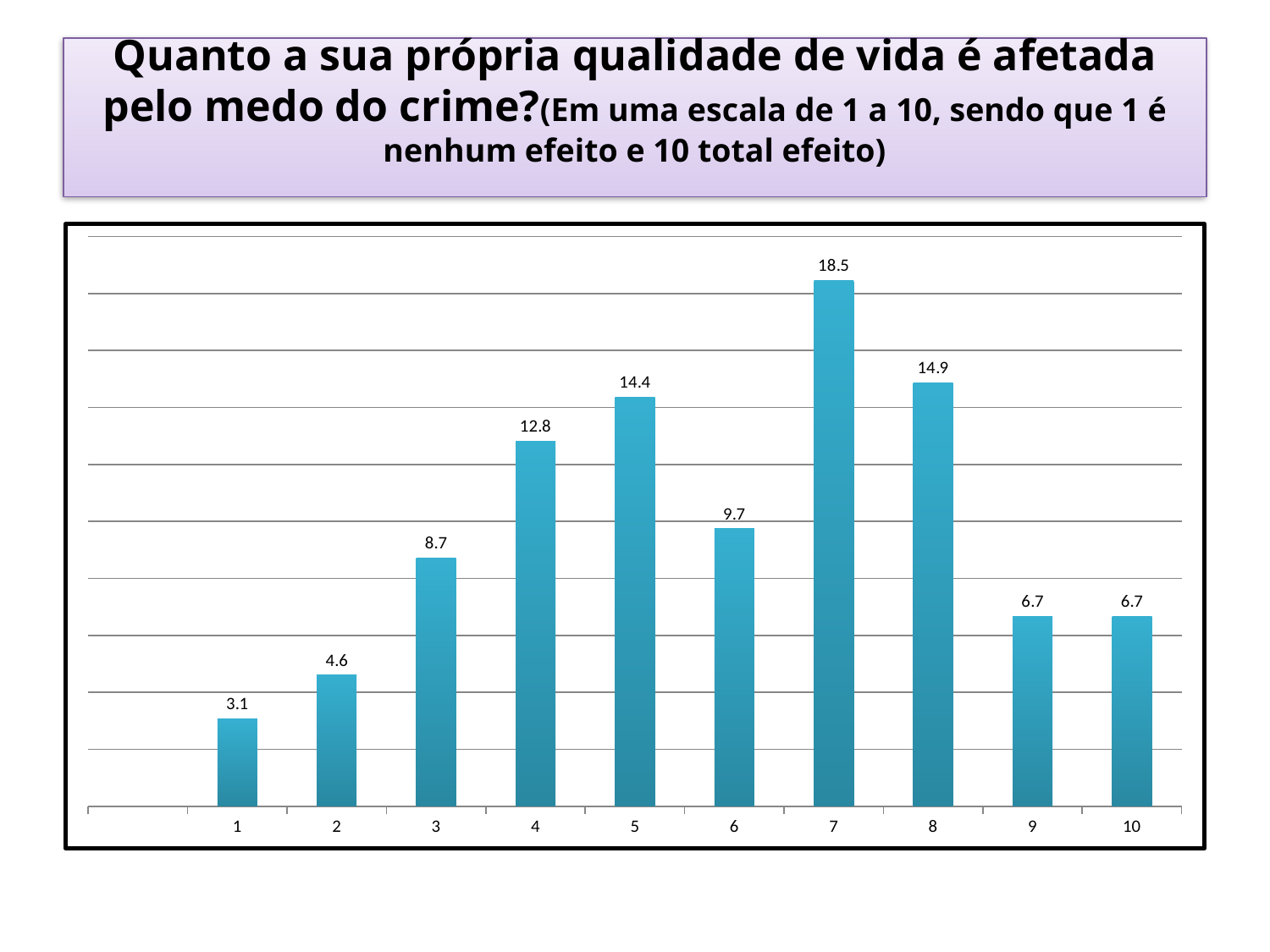
Which category has the lowest value? 1 How many categories are shown on the x axis? 10 What is the value for category 7? 18.5 What is the value for category 4? 12.8 What is the value for category 1? 3.1 Which two categories share the same value of 6.7? 9 and 10 Do the values rise or fall from category 1 to category 4? rise Which category has the highest value? 7 What is the difference between the values for category 7 and category 8? 3.6 Which is larger, the value for category 3 or the value for category 6? 6 What kind of chart is shown on the slide? bar chart What is the difference between the values for category 5 and category 6? 4.7